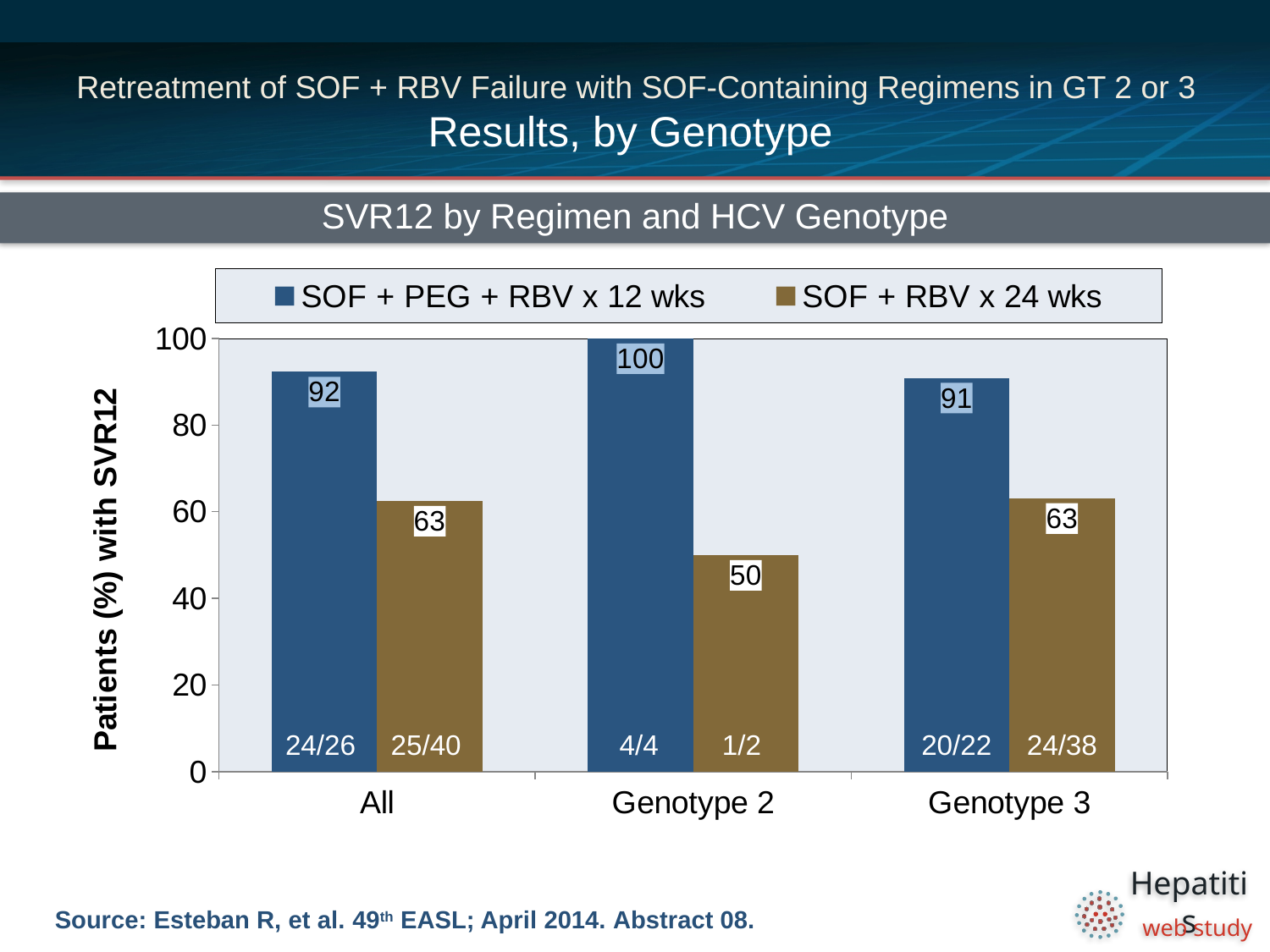
What is the SVR12 rate for SOF + PEG + RBV x 12 wks in the All group? 92 What is the SVR12 rate for SOF + RBV x 24 wks in Genotype 2? 50 What fraction of patients is shown for SOF + RBV x 24 wks in Genotype 3? 24/38 What is the label of the y axis? Patients (%) with SVR12 What is the SVR12 rate for SOF + PEG + RBV x 12 wks in Genotype 3? 91 In the All group, which regimen has the higher SVR12 rate? SOF + PEG + RBV x 12 wks What kind of chart is shown on the slide? Bar chart How many series does the legend list? 2 Which genotype group has the lowest SVR12 rate for SOF + RBV x 24 wks? Genotype 2 How many genotype categories are shown on the x axis? 3 What is the difference in SVR12 rate between SOF + PEG + RBV x 12 wks and SOF + RBV x 24 wks in Genotype 2? 50 Which genotype group has the highest SVR12 rate for SOF + PEG + RBV x 12 wks? Genotype 2